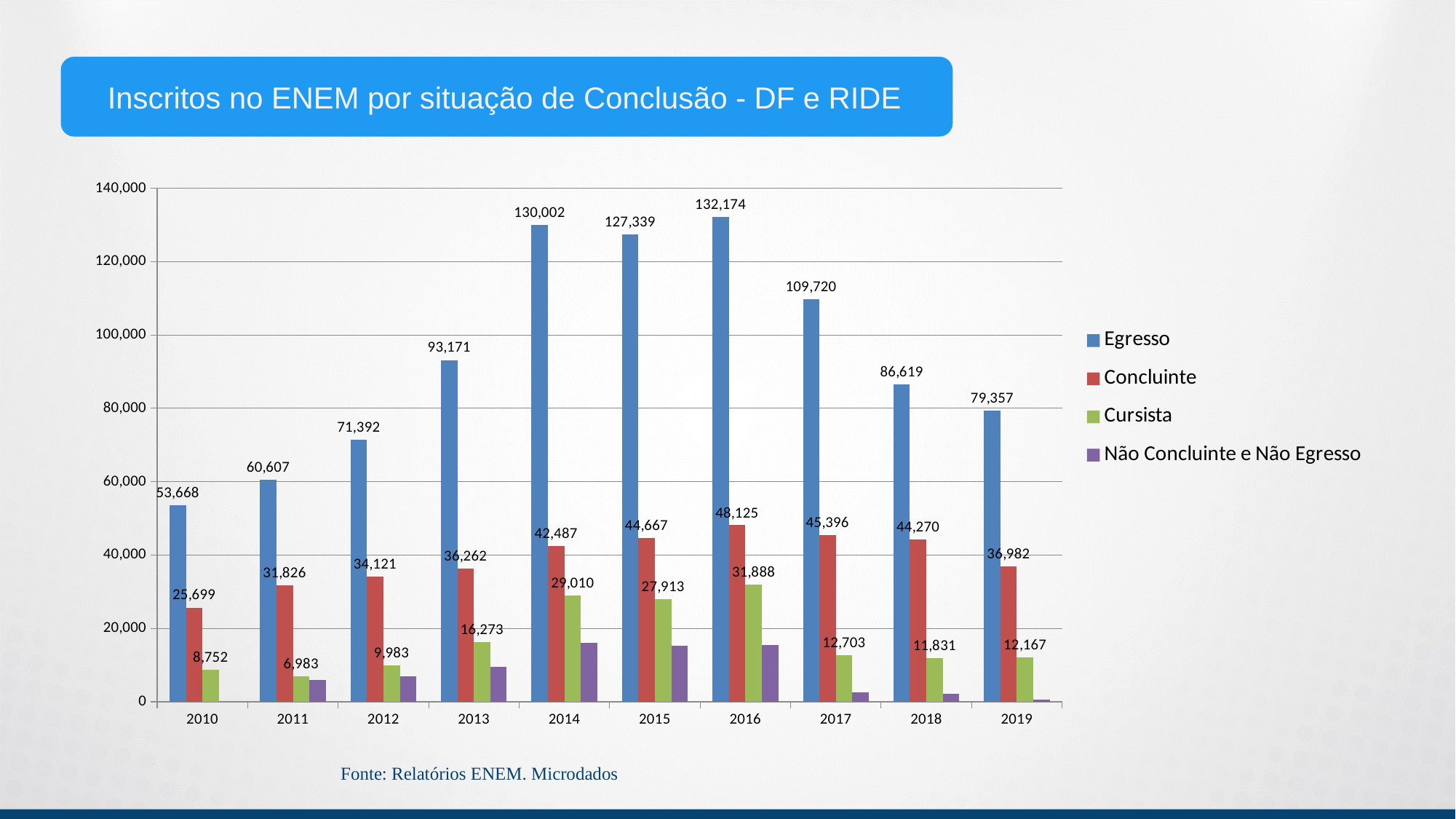
In which year is the Egresso value highest? 2016 How many years are shown on the x axis? 10 Is the value for Não Concluinte e Não Egresso in 2014 greater or less than 20,000? less What is the value for Cursista in 2013? 16,273 In which year is the Cursista value lowest? 2011 Do the Egresso values rise or fall from 2016 to 2019? fall What is the difference between the Egresso values for 2016 and 2015? 4,835 What is the value for Concluinte in 2019? 36,982 What kind of chart is shown on the slide? bar chart Which is larger, the Concluinte value in 2017 or in 2018? 2017 How many series does the legend list? 4 What is the value for Egresso in 2014? 130,002